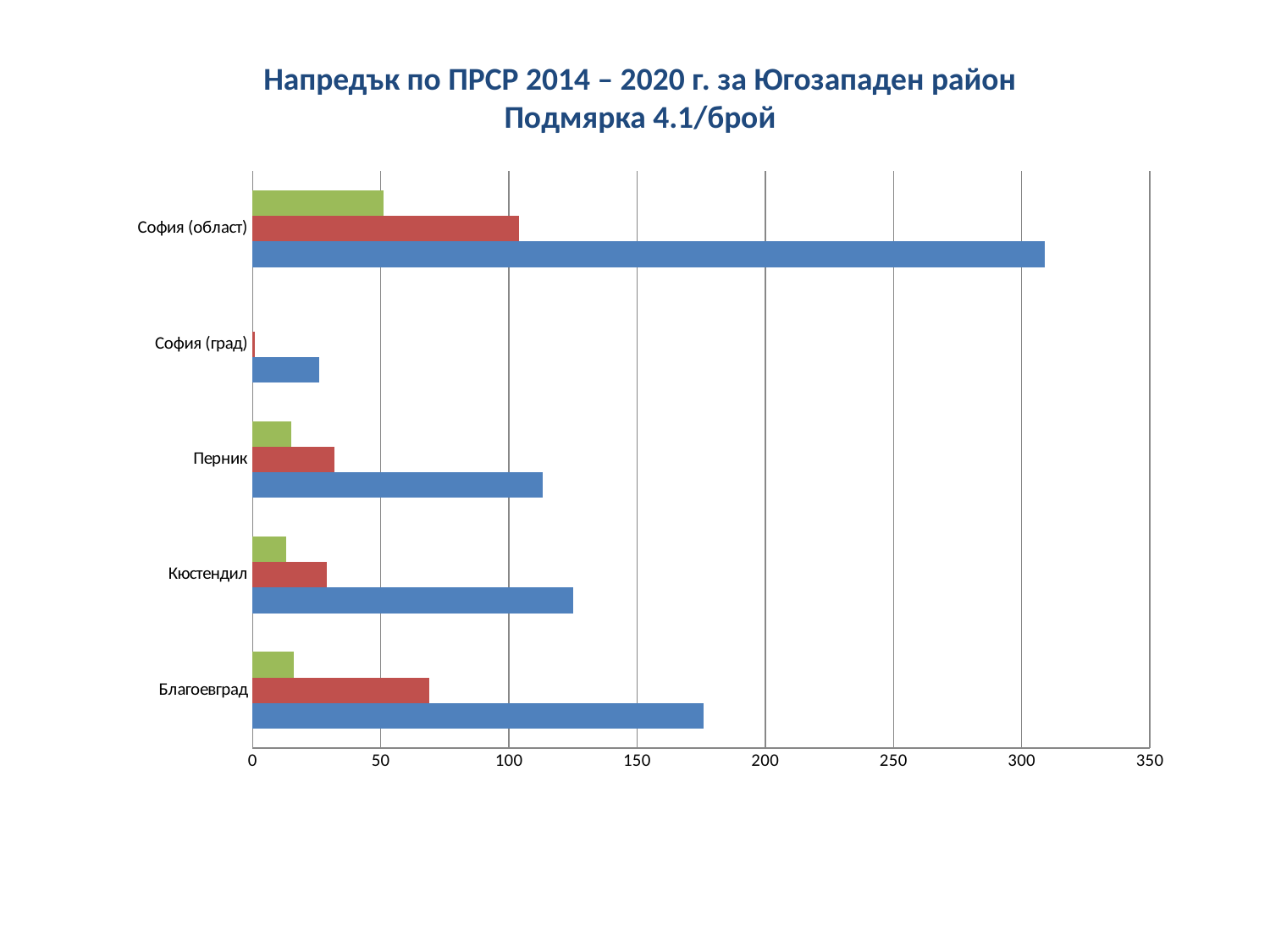
Which is larger, the blue bar for Благоевград or the blue bar for Перник? Благоевград Is the blue bar for Благоевград greater or less than 150? greater Is the blue bar for София (област) greater or less than 300? greater Which category has the shortest blue bar? София (град) How many differently coloured bar series are plotted for each category? 3 What is the title of the chart? Напредък по ПРСР 2014 – 2020 г. за Югозападен район Подмярка 4.1/брой Which category has the longest blue bar? София (област) Is the blue bar for София (град) greater or less than 50? less Which is larger, the red bar for Благоевград or the red bar for Кюстендил? Благоевград What kind of chart is shown on the slide? bar chart How many categories are shown on the vertical axis of the chart? 5